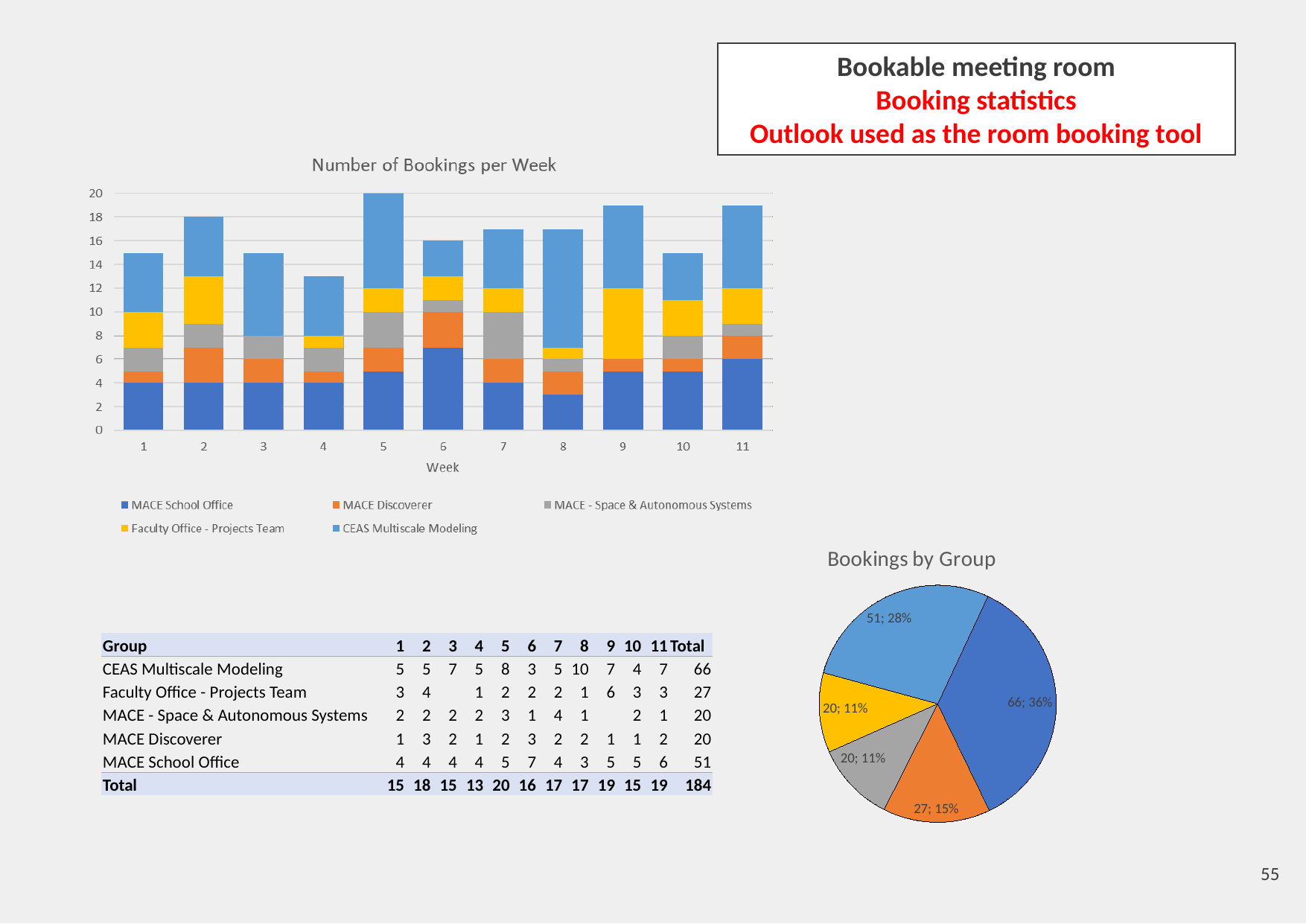
In "Number of Bookings per Week", is the total for week 4 greater or less than 14? less What kind of chart is "Bookings by Group"? Pie chart In "Number of Bookings per Week", which week has more total bookings, week 2 or week 3? Week 2 What kind of chart is "Number of Bookings per Week"? Stacked bar chart In "Number of Bookings per Week", which week has the lowest total number of bookings? Week 4 What is the x-axis title of "Number of Bookings per Week"? Week In "Number of Bookings per Week", what is the total number of bookings in week 5? 20 In "Bookings by Group", what is the difference between the values of the two largest slices (66 and 51)? 15 In "Number of Bookings per Week", which week has the highest total number of bookings? Week 5 In "Bookings by Group", what share does the largest slice have? 36% How many weeks are shown on the x axis of "Number of Bookings per Week"? 11 How many series does the legend of "Number of Bookings per Week" list? 5